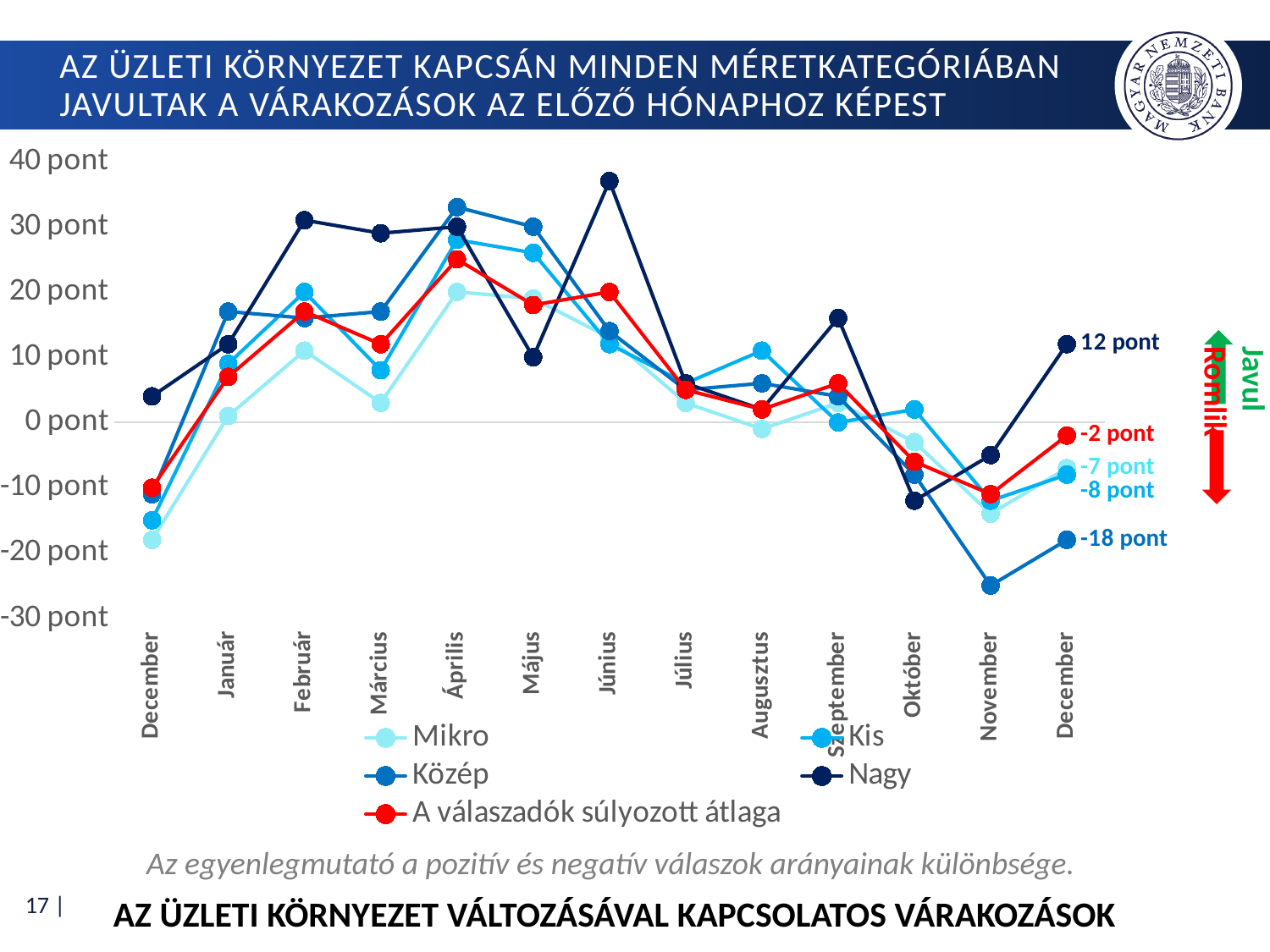
Which series has the highest value at the final December? Nagy How many months are shown on the x axis? 13 What is the value of the Nagy series at the final December on the chart? 12 pont How many series does the legend list? 5 What is the difference between the Nagy and Közép values at the final December? 30 pont Which series has the lowest value at the final December? Közép What is the value of the Közép series at the final December? -18 pont At the final December, which is higher: the Mikro value or the Kis value? Mikro What is the value of the Mikro series at the final December? -7 pont What is the value of 'A válaszadók súlyozott átlaga' at the final December? -2 pont What kind of chart is shown on the slide? line chart Is the value of the Nagy series in Június greater or less than 30 pont? greater